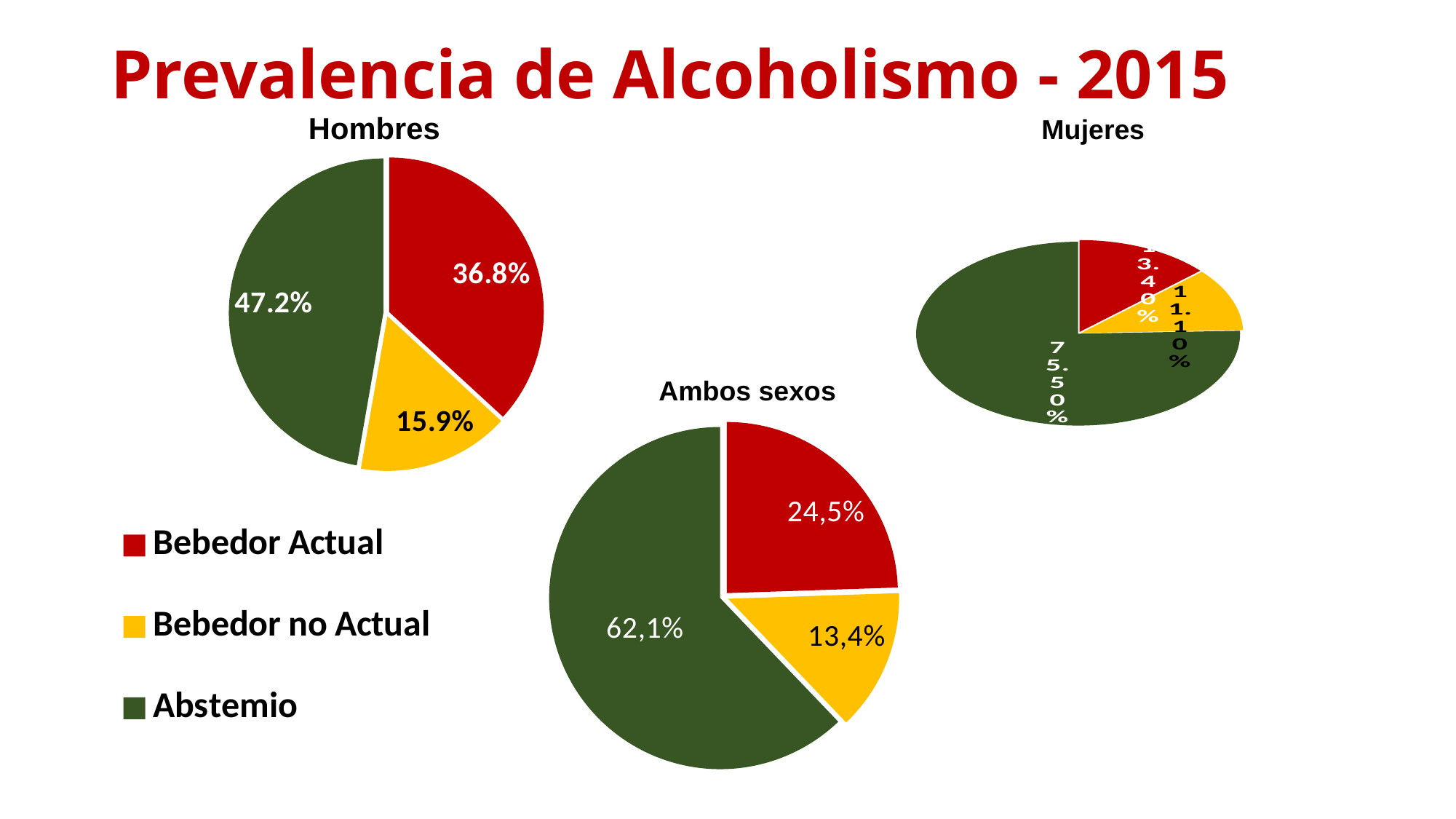
In the Mujeres pie chart, which category has the largest share? Abstemio In the Ambos sexos pie chart, what is the value for Bebedor Actual? 24,5% In the Ambos sexos pie chart, what is the value for Bebedor no Actual? 13,4% How many categories does the legend list? 3 In the Hombres pie chart, what is the value for Abstemio? 47.2% In the Hombres pie chart, what is the difference between Bebedor Actual and Bebedor no Actual? 20.9% In the Hombres pie chart, what is the value for Bebedor Actual? 36.8% In the Ambos sexos pie chart, what is the value for Abstemio? 62,1% In the Hombres pie chart, what is the value for Bebedor no Actual? 15.9% In the Hombres pie chart, which category has the largest share? Abstemio What type of chart is used for Ambos sexos? Pie chart In the Ambos sexos pie chart, which category has the smallest share? Bebedor no Actual